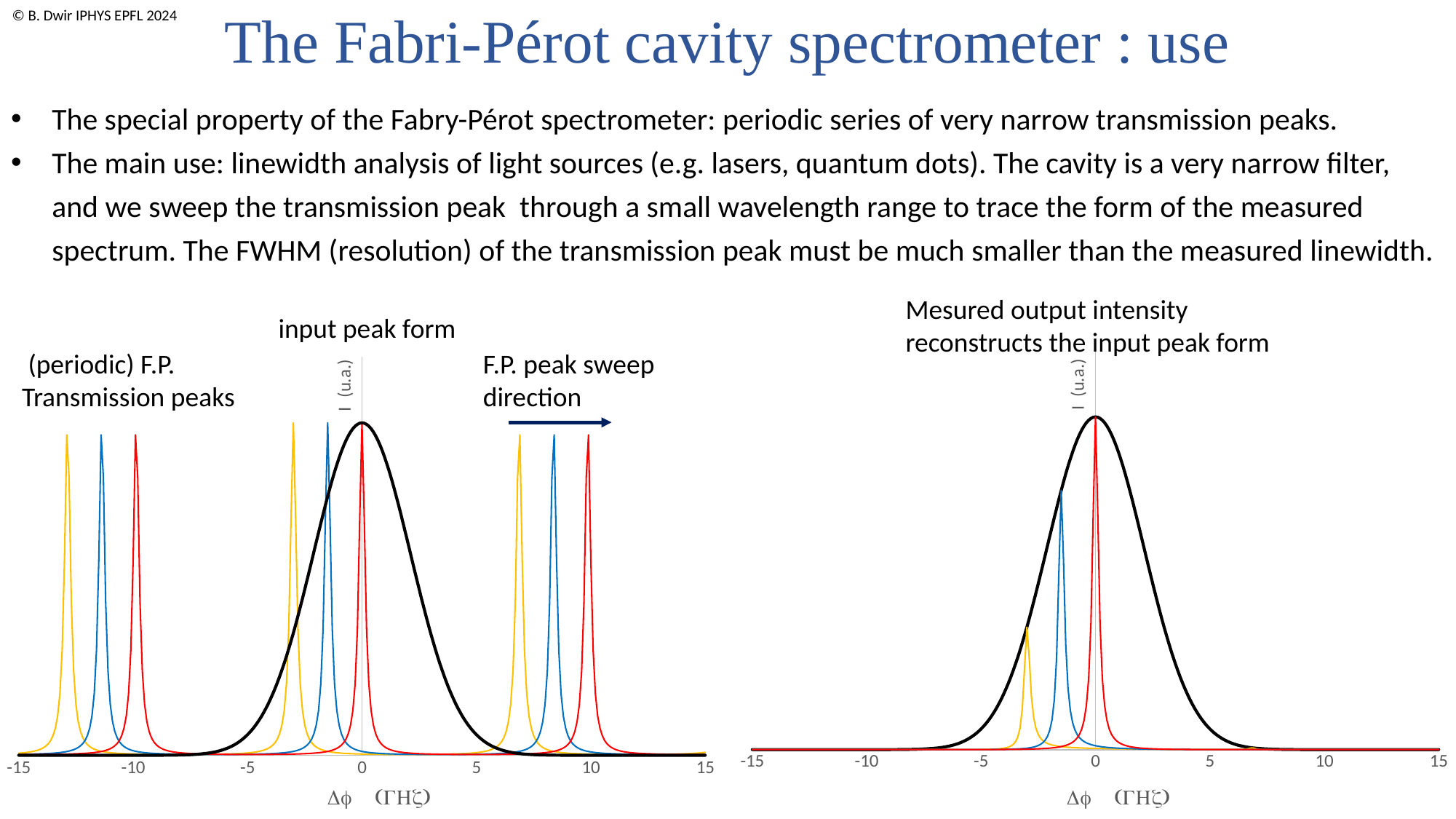
On the right chart, is the x position of the yellow peak greater or less than 0? less On the left chart, what is the lowest value labelled on the x axis? -15 On the right chart, which coloured narrow peak is the lowest? yellow On the right chart, does the black curve rise or fall as x goes from 0 to 15? fall On the left chart, at which x-axis value does the black input peak reach its maximum? 0 On the left chart, how many red peaks are plotted? 3 On the right chart, what is the highest value labelled on the x axis? 15 What kind of chart is the left chart? line chart On the left chart, at which x-axis tick values do the red peaks occur? -10, 0, 10 On the left chart, how many tick labels are shown on the x axis? 7 On the left chart, what is the spacing on the x axis between two neighbouring red peaks? 10 On the right chart, which coloured narrow peak is the tallest? red